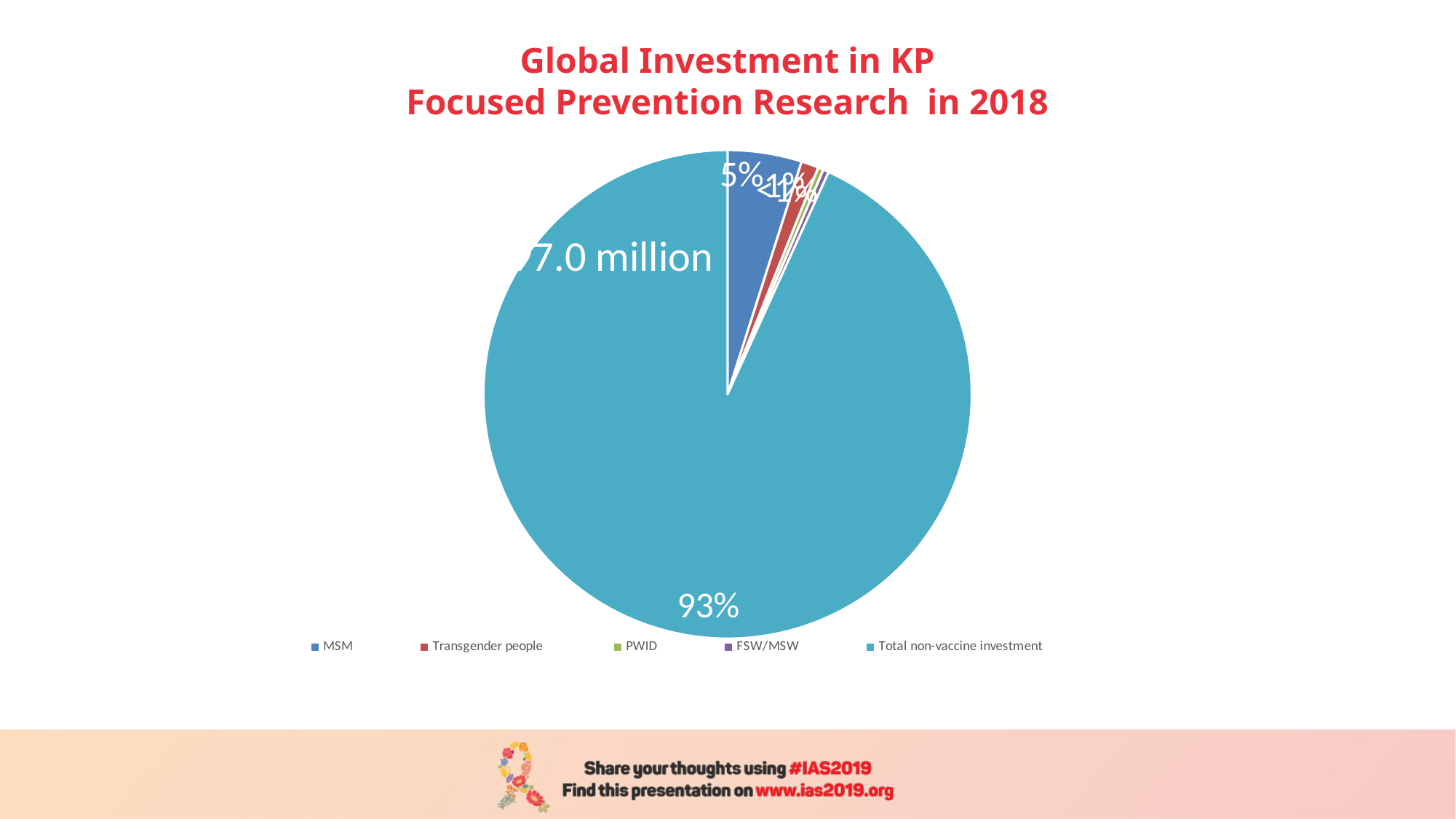
How many categories does the legend of the pie chart list? 5 Is the share for Total non-vaccine investment greater or less than 50%? greater Which is larger, the slice for MSM or the slice for Total non-vaccine investment? Total non-vaccine investment Which is larger, the slice for MSM or the slice for Transgender people? MSM What share of the pie is labelled for Total non-vaccine investment? 93% What kind of chart is shown on the slide? Pie chart Which legend entry is shown in red? Transgender people Which category has the largest slice of the pie? Total non-vaccine investment What is the difference in percentage points between the Total non-vaccine investment slice and the MSM slice? 88 percentage points What is the title of the chart? Global Investment in KP Focused Prevention Research in 2018 What share of the pie is labelled for MSM? 5%